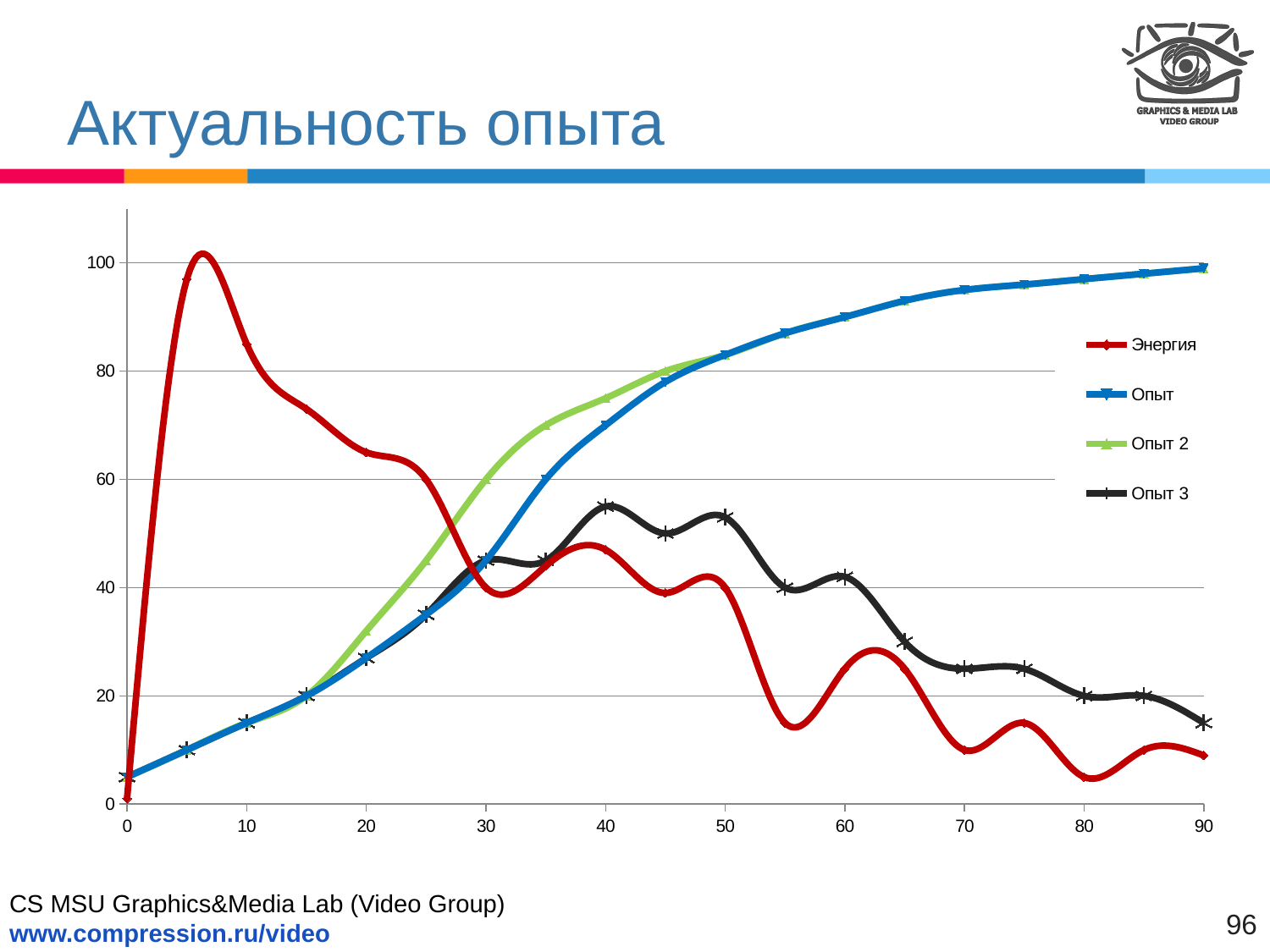
What is the title of the slide containing the chart? Актуальность опыта At x = 10, which series has the larger value, Энергия or Опыт? Энергия Is the value of Опыт 2 at x = 40 greater or less than 60? greater Is the value of Энергия at x = 90 greater or less than 20? less At x = 70, which series has the larger value, Опыт 3 or Энергия? Опыт 3 Which colour is used for the Энергия series? red What kind of chart is shown on the slide? line chart Is the value of Опыт at x = 90 greater or less than 80? greater Does the Опыт series rise or fall as x increases from 0 to 90? rise How many series does the legend list? 4